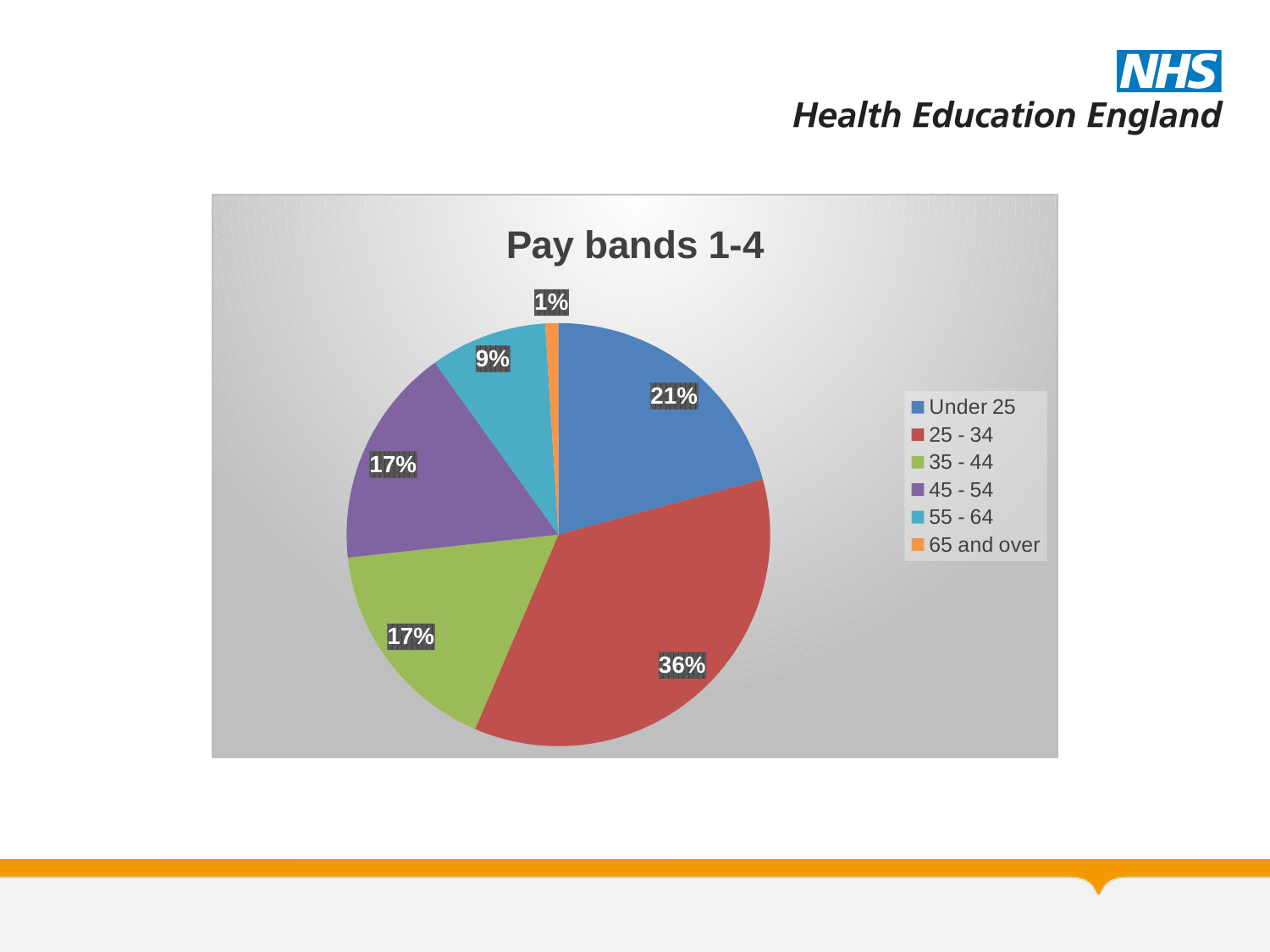
Which age group has the largest share of the pie? 25 - 34 What is the difference between the shares for 25 - 34 and Under 25? 15% What share of the pie does the 65 and over slice represent? 1% Which is larger, the share for Under 25 or the share for 55 - 64? Under 25 What type of chart is shown on the slide? pie chart Which age group has the smallest share of the pie? 65 and over How many age groups does the legend list? 6 What is the title of the chart? Pay bands 1-4 What colour is the slice for 45 - 54? purple What share of the pie does the 25 - 34 slice represent? 36% What share of the pie does the 55 - 64 slice represent? 9%